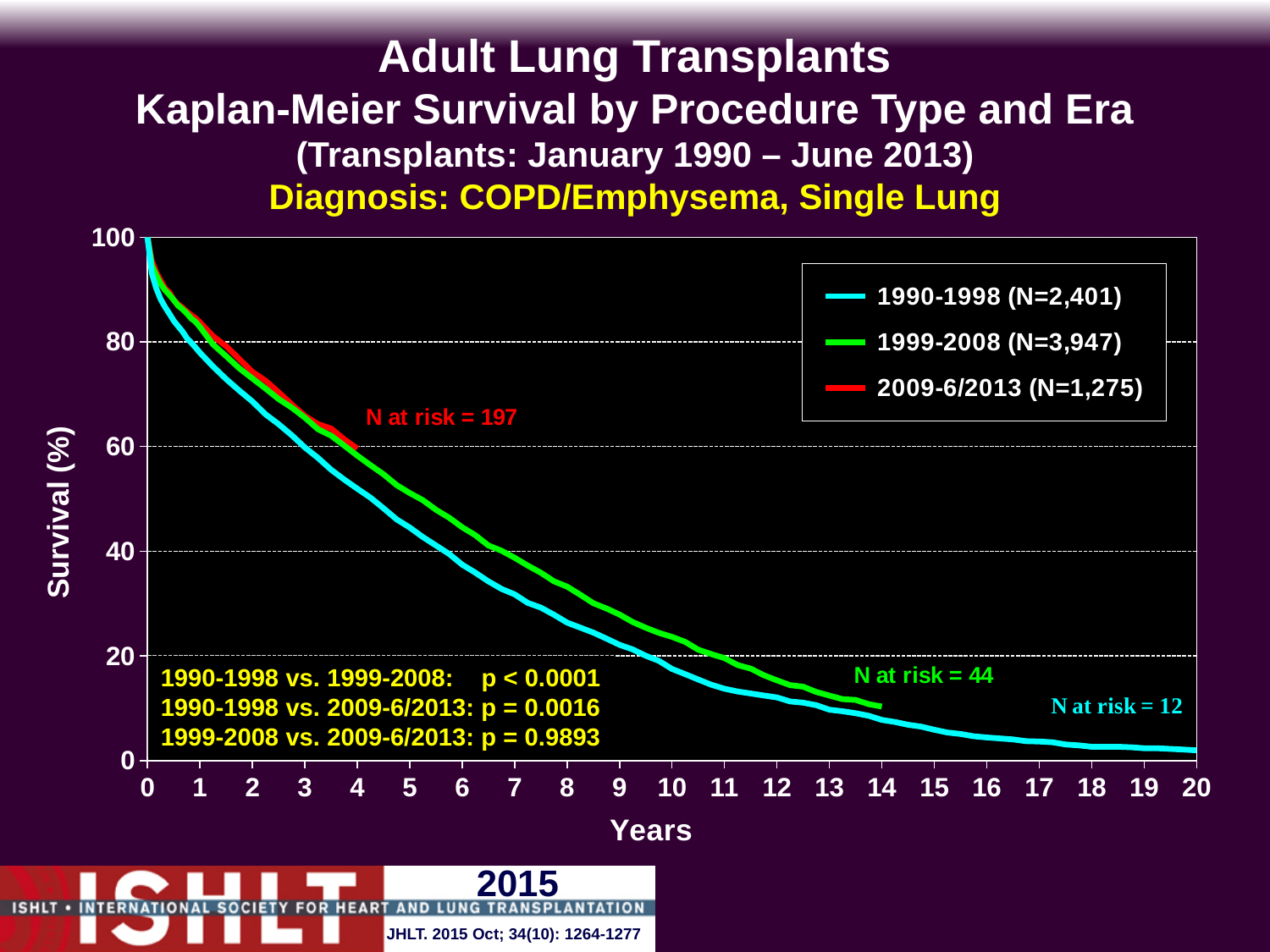
What is the N for the 1999-2008 era shown in the legend? N=3,947 What is the N at risk shown at the end of the 1990-1998 curve? 12 What is the difference between the N for 1999-2008 and the N for 1990-1998? 1,546 Which era has the largest N in the legend? 1999-2008 Is the survival value for the 1999-2008 curve at year 10 greater or less than 20? greater Do the survival curves rise or fall as years increase? Fall What kind of chart is shown on the slide? Line chart Which era has the smallest N in the legend? 2009-6/2013 What is the N for the 1990-1998 era shown in the legend? N=2,401 What is the N at risk shown at the end of the 2009-6/2013 curve? 197 What is the N for the 2009-6/2013 era shown in the legend? N=1,275 How many series does the legend list? 3